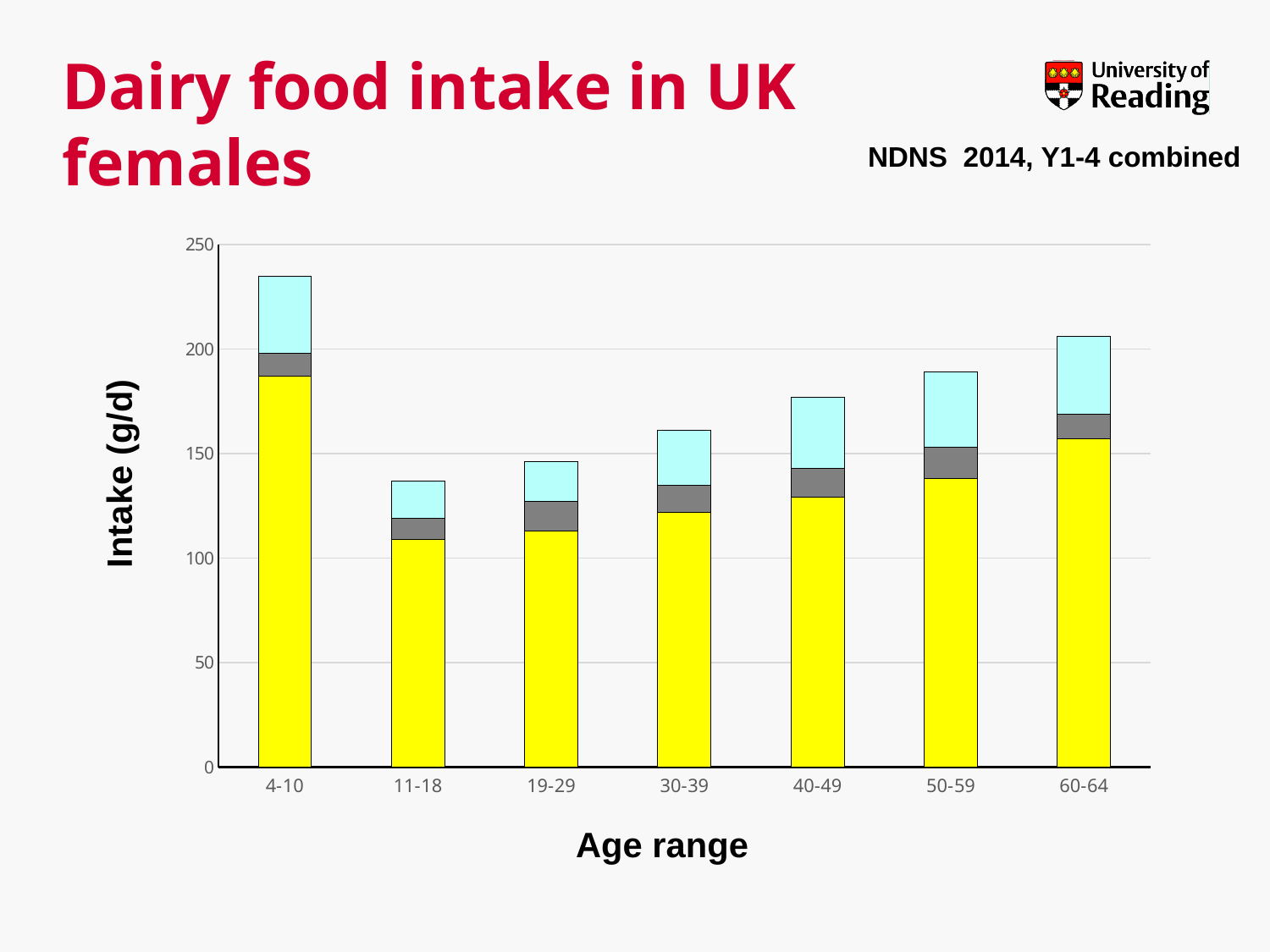
What is the label on the x axis of the chart? Age range Which age range has the lowest total dairy food intake? 11-18 Is the total intake for the 50-59 age range greater or less than 200 g/d? less Which has the larger total intake, the 60-64 or the 50-59 age range? 60-64 What is the label on the y axis of the chart? Intake (g/d) Is the total intake for the 4-10 age range greater or less than 200 g/d? greater From the 11-18 age range through to the 60-64 age range, do the total intake values rise or fall? rise Which age range has the highest total dairy food intake? 4-10 What kind of chart is shown on the slide? Stacked bar chart How many age range categories are plotted on the x axis? 7 Is the total intake for the 11-18 age range greater or less than 150 g/d? less